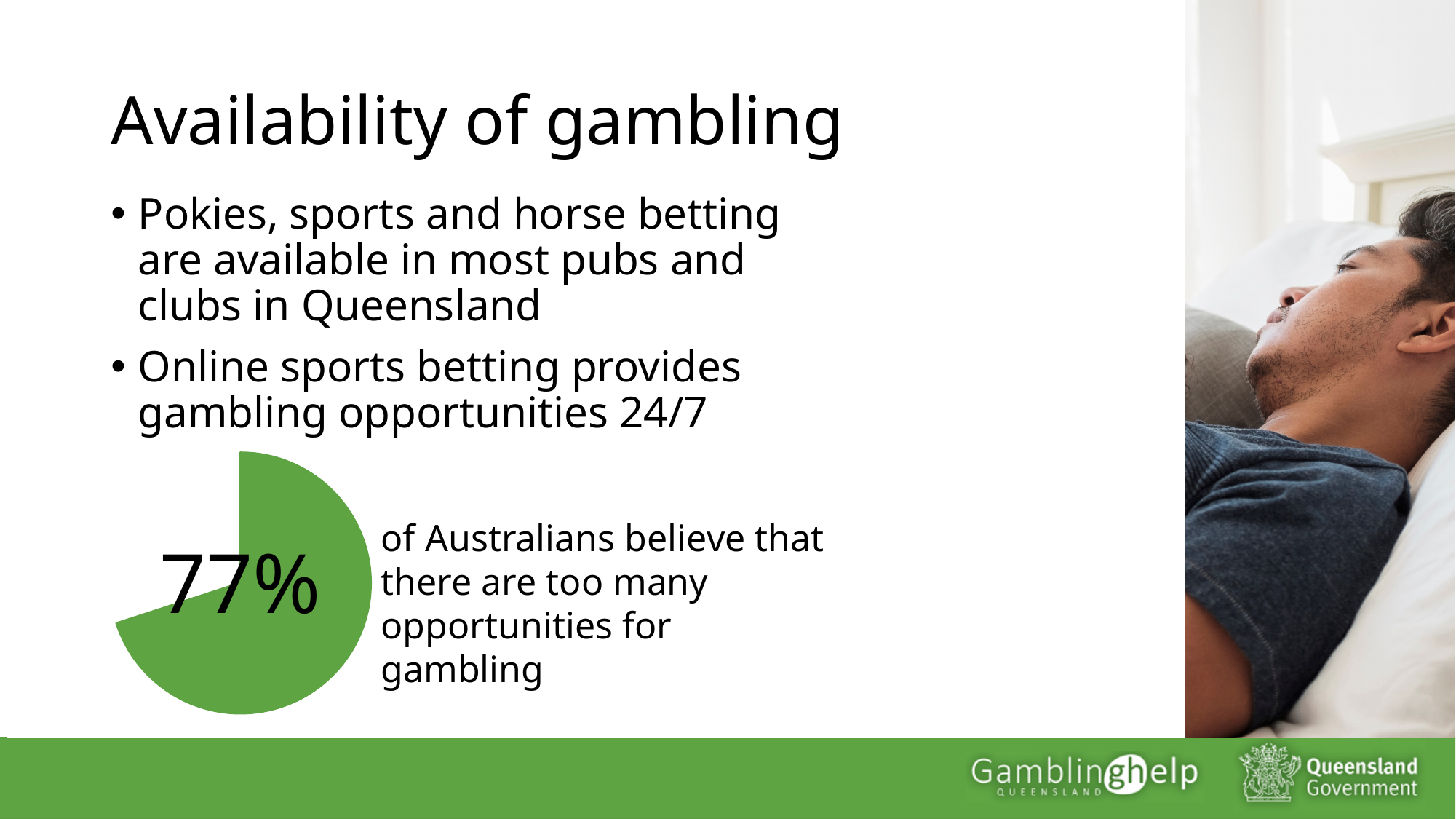
Is the value shown on the pie chart greater or less than 50%? greater What kind of chart is shown on the slide? pie chart What percentage is printed on the pie chart? 77% What colour is the filled slice of the pie chart? green Does the green slice of the pie chart represent more or less than half of the pie? more What share of Australians believe there are too many opportunities for gambling, according to the pie chart? 77%